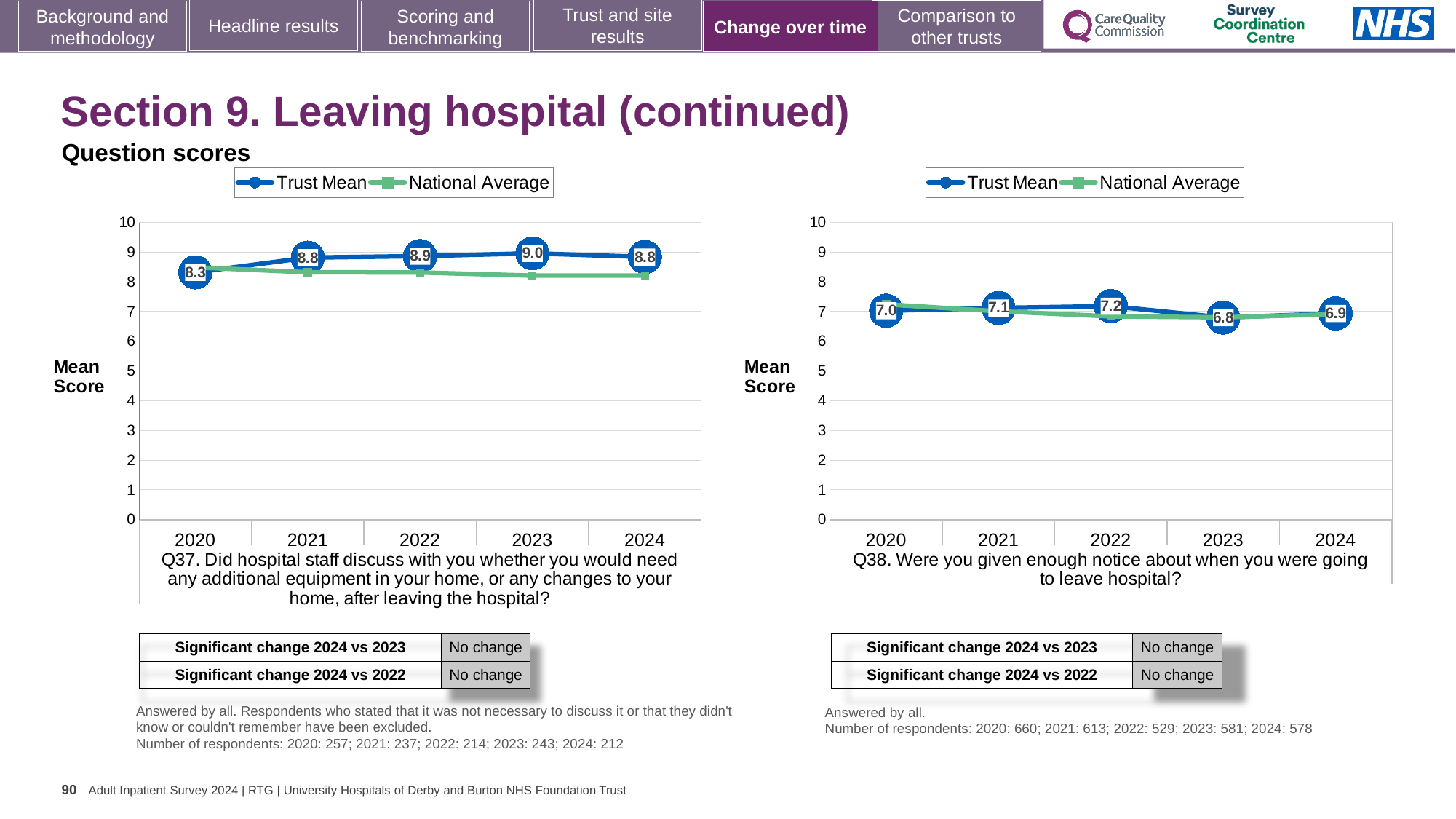
How many series does the legend of the Q38 chart (right) list? 2 What type of chart is used for Q37 (left)? Line chart In the Q38 chart (right), what is the Trust Mean score for 2022? 7.2 In the Q37 chart (left), which year has the lowest Trust Mean score? 2020 In the Q37 chart (left), what is the Trust Mean score for 2023? 9.0 In the Q38 chart (right), is the National Average value for 2020 greater or less than 5? greater In the Q37 chart (left), what is the difference between the Trust Mean scores for 2023 and 2020? 0.7 In the Q38 chart (right), is the Trust Mean score for 2024 higher or lower than for 2023? higher How many years are plotted on the x axis of the Q37 chart (left)? 5 In the Q37 chart (left), which year has the highest Trust Mean score? 2023 In the Q38 chart (right), which year has the lowest Trust Mean score? 2023 In the Q37 chart (left), what is the Trust Mean score for 2020? 8.3